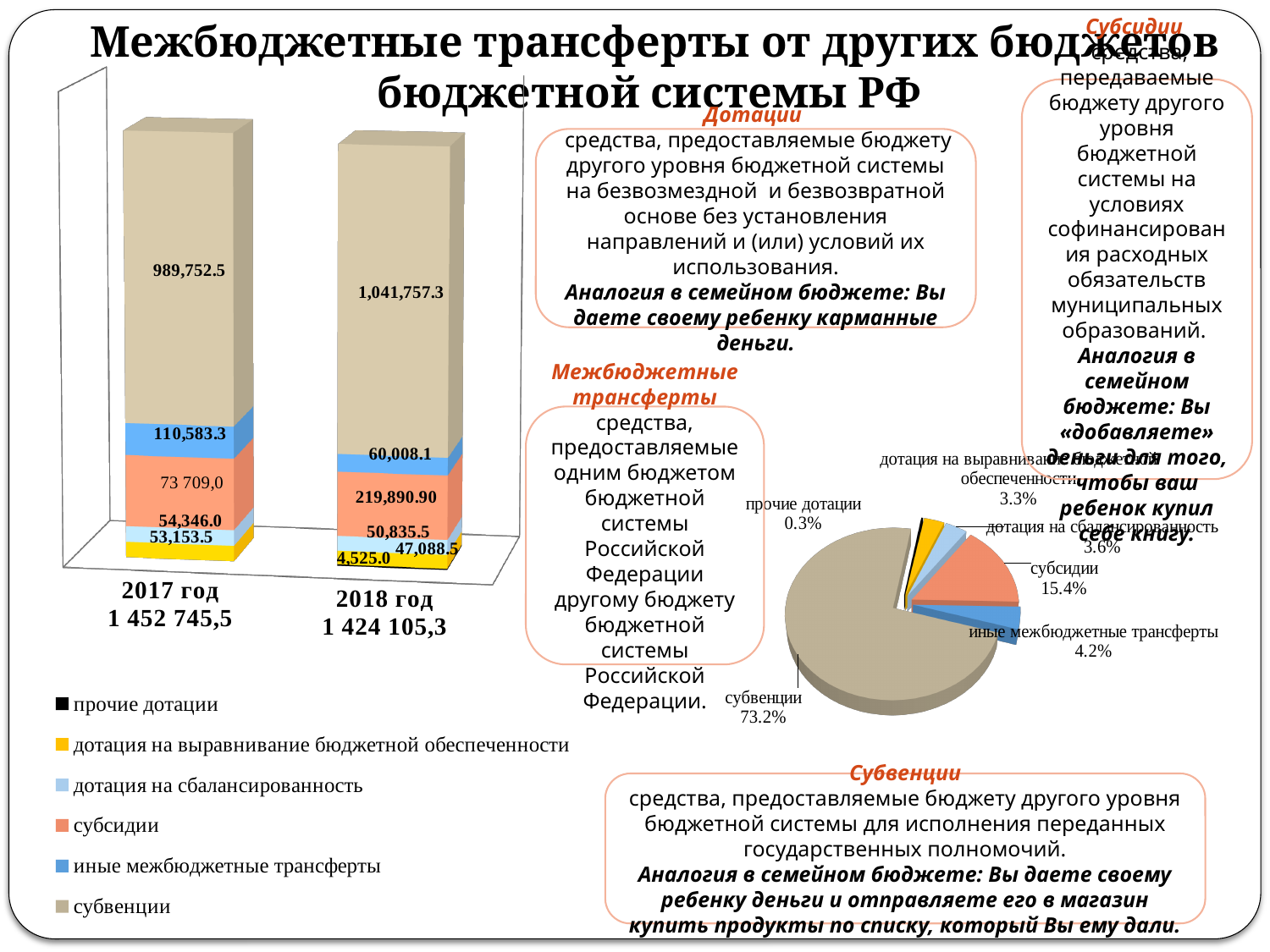
What type of chart is the chart on the left of the slide? Stacked bar chart In the stacked bar chart on the left, how many series does the legend list? 6 In the pie chart, what share do субсидии have? 15.4% In the pie chart, what is the difference between the share of иные межбюджетные трансферты and the share of дотация на сбалансированность? 0.6% In the stacked bar chart on the left, what is the value of субвенции for 2018 год? 1,041,757.3 In the stacked bar chart on the left, what is the value of иные межбюджетные трансферты for 2017 год? 110,583.3 In the stacked bar chart on the left, what is the value of субвенции for 2017 год? 989,752.5 In the stacked bar chart on the left, which year has the larger value of субвенции, 2017 год or 2018 год? 2018 год In the stacked bar chart on the left, what is the value of субсидии for 2018 год? 219,890.90 In the pie chart, which category has the smallest share? прочие дотации In the pie chart, what share do субвенции have? 73.2% In the stacked bar chart on the left, what is the total shown for 2018 год? 1 424 105,3